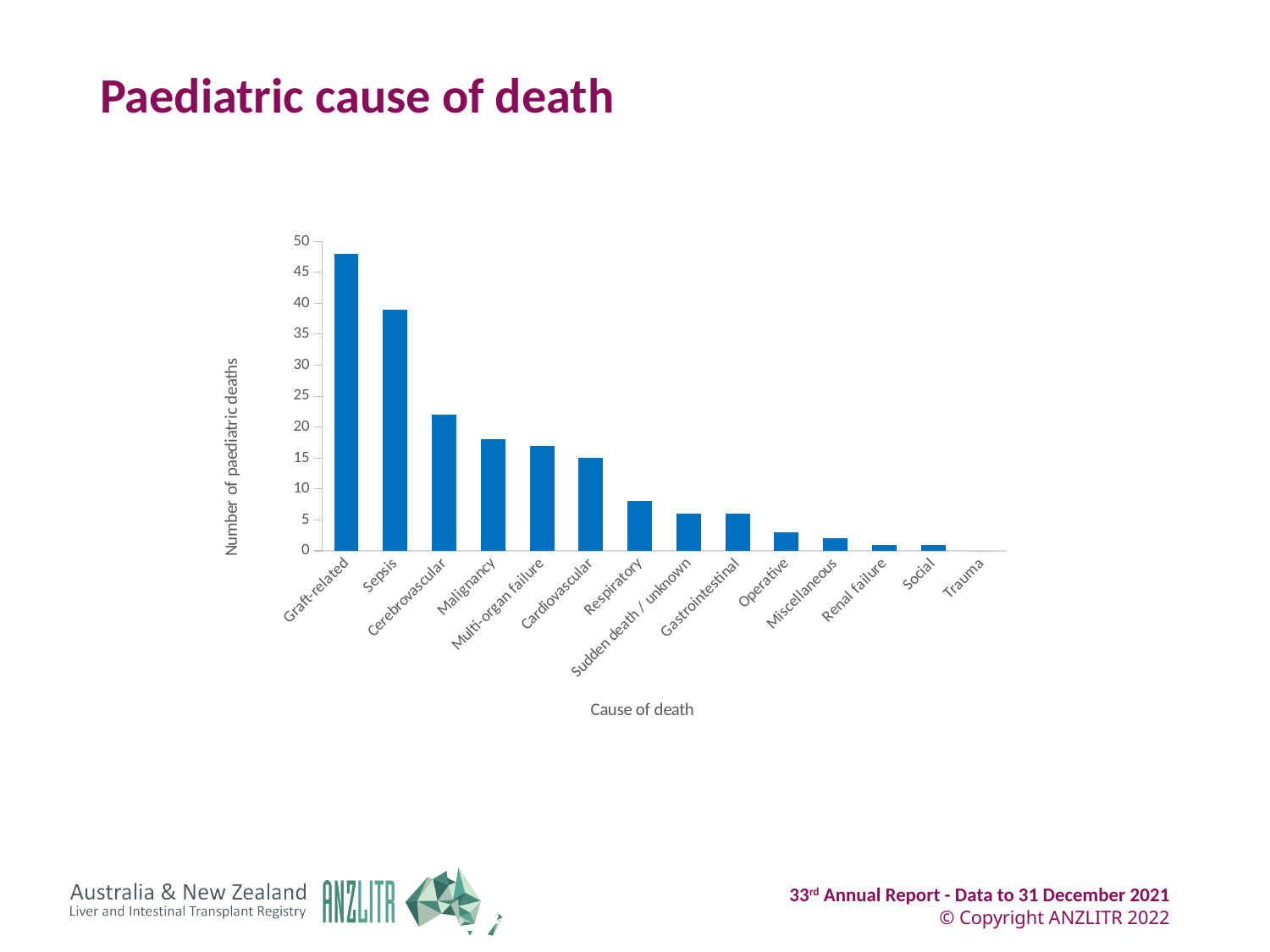
Is the value for Graft-related greater or less than 45? greater Which has more paediatric deaths, Sepsis or Cerebrovascular? Sepsis Which cause of death has the highest number of paediatric deaths? Graft-related Which cause of death has the lowest number of paediatric deaths? Trauma Which has more paediatric deaths, Respiratory or Operative? Respiratory Is the value for Cerebrovascular greater or less than 20? greater What kind of chart is shown on the slide? Bar chart Is the value for Respiratory greater or less than 10? less How many causes of death are shown on the x axis? 14 Do the values rise or fall moving from left to right along the x axis? Fall What is the label on the y axis of the chart? Number of paediatric deaths